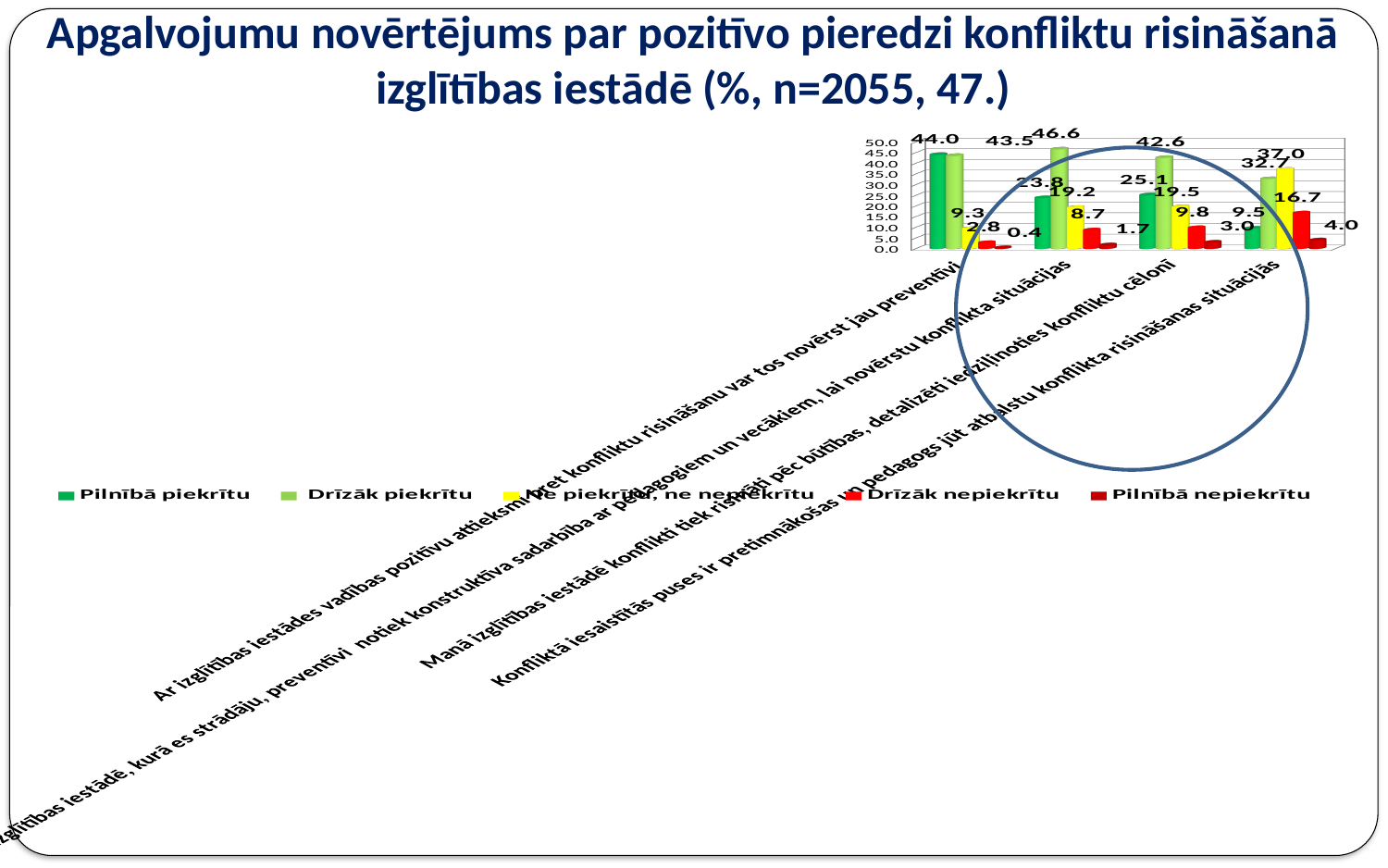
What kind of chart is shown on the slide? bar chart Is the "Pilnībā piekrītu" value larger for the second statement or the third statement? third statement Do the "Drīzāk nepiekrītu" values rise or fall from the first statement to the last? rise How many statement categories are plotted along the x axis? 4 What is the value of "Drīzāk nepiekrītu" for the last statement ("Konfliktā iesaistītās puses ir pretimnākošas...")? 16.7 What is the value of "Drīzāk piekrītu" for the second statement? 46.6 What colour represents "Pilnībā nepiekrītu" in the legend? dark red How many series does the legend list? 5 Which response series has the highest value for the last statement ("Konfliktā iesaistītās puses ir pretimnākošas...")? Ne piekrītu, ne nepiekrītu For which statement is the "Pilnībā nepiekrītu" value lowest? the first statement (0.4) What is the difference between "Pilnībā piekrītu" (44.0) and "Drīzāk piekrītu" (43.5) for the first statement? 0.5 What is the value of "Pilnībā piekrītu" for the first (leftmost) statement? 44.0